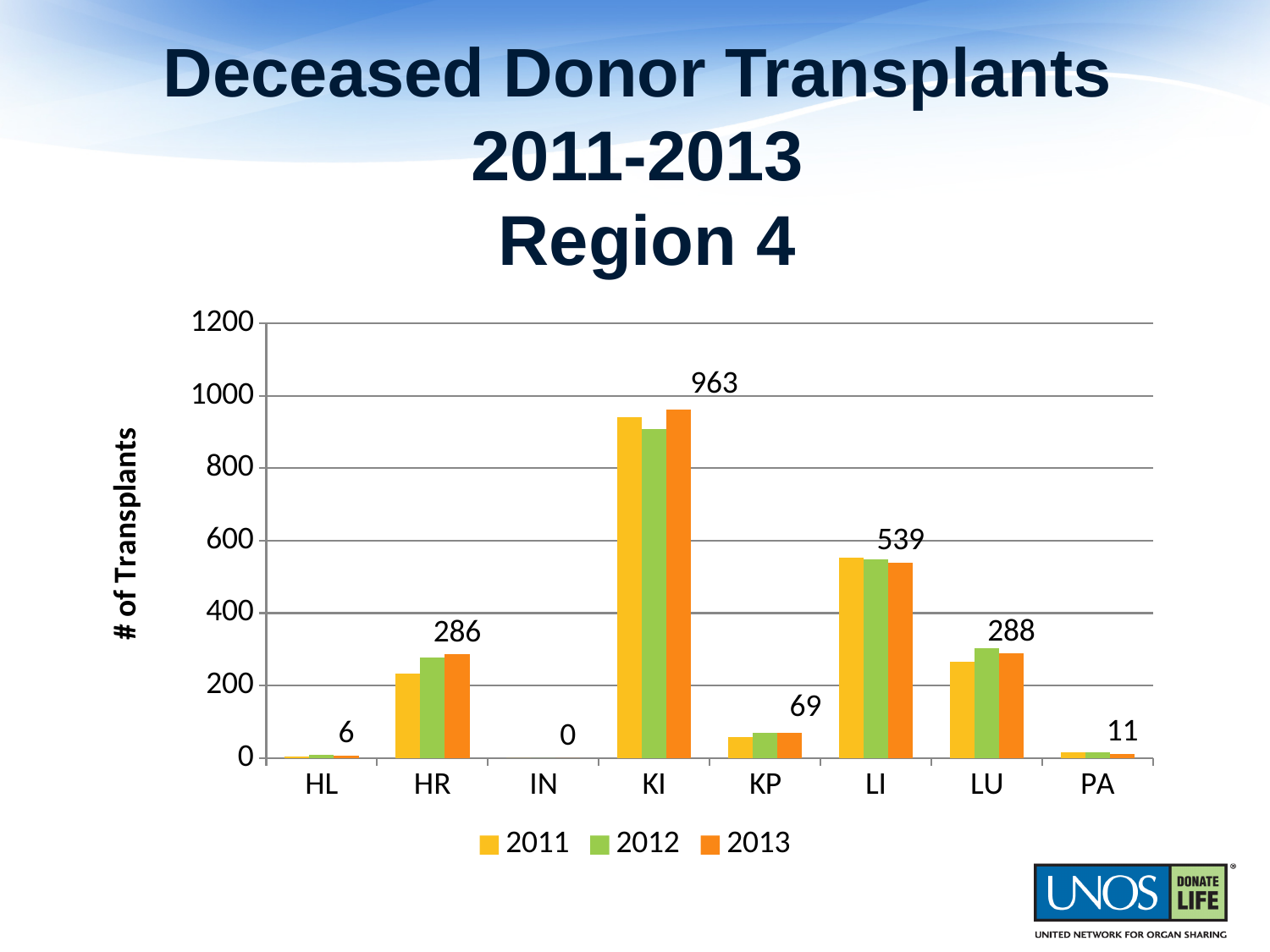
What is the 2013 value for LI? 539 Which is larger in 2013, the value for HR or the value for LU? LU Is the 2011 value for KI greater or less than 800? greater What type of chart is shown on the slide? bar chart What is the 2013 value for HR? 286 How many series does the legend list? 3 Which organ category has the highest number of transplants in 2013? KI What is the 2013 value for PA? 11 How many organ categories are shown on the x axis? 8 What is the 2013 value for KI? 963 Which organ category has the lowest number of transplants in 2013? IN What is the difference between the 2013 values for KI and LI? 424